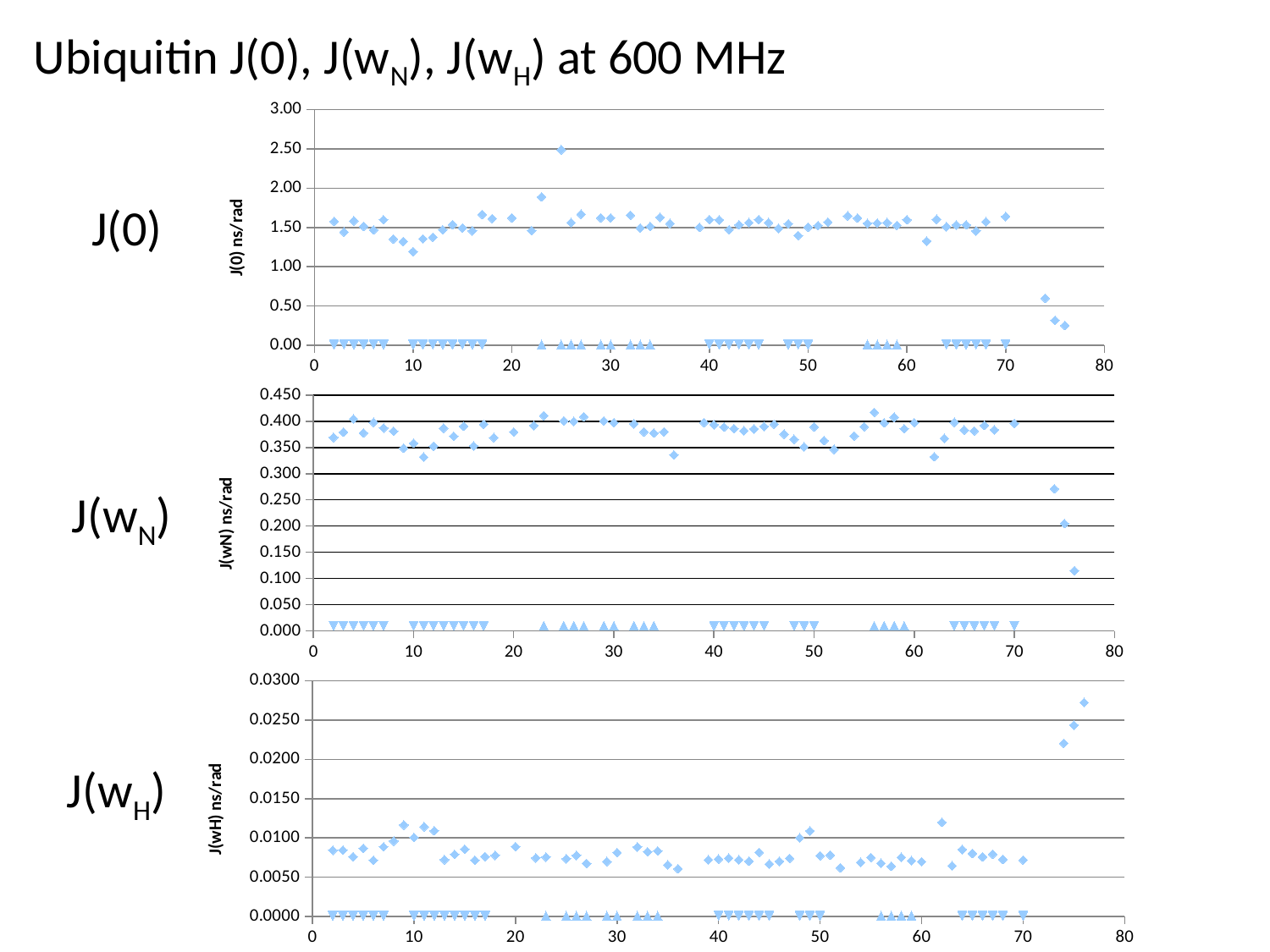
In the bottom chart (J(wH)), at which x value does the highest point occur? 76 In the top chart (J(0)), at which x value does the highest point occur? 25 In the bottom chart (J(wH)), what is the label on the vertical axis? J(wH) ns/rad In the top chart (J(0)), is the value at x = 25 greater or less than 2.00? greater In the top chart (J(0)), is the value at x = 76 greater or less than 0.50? less In the top chart (J(0)), what is the label on the vertical axis? J(0) ns/rad In the middle chart (J(wN)), is the value at x = 10 greater or less than 0.300? greater What kind of chart is the top chart labelled J(0)? scatter chart How many charts are shown on the slide? 3